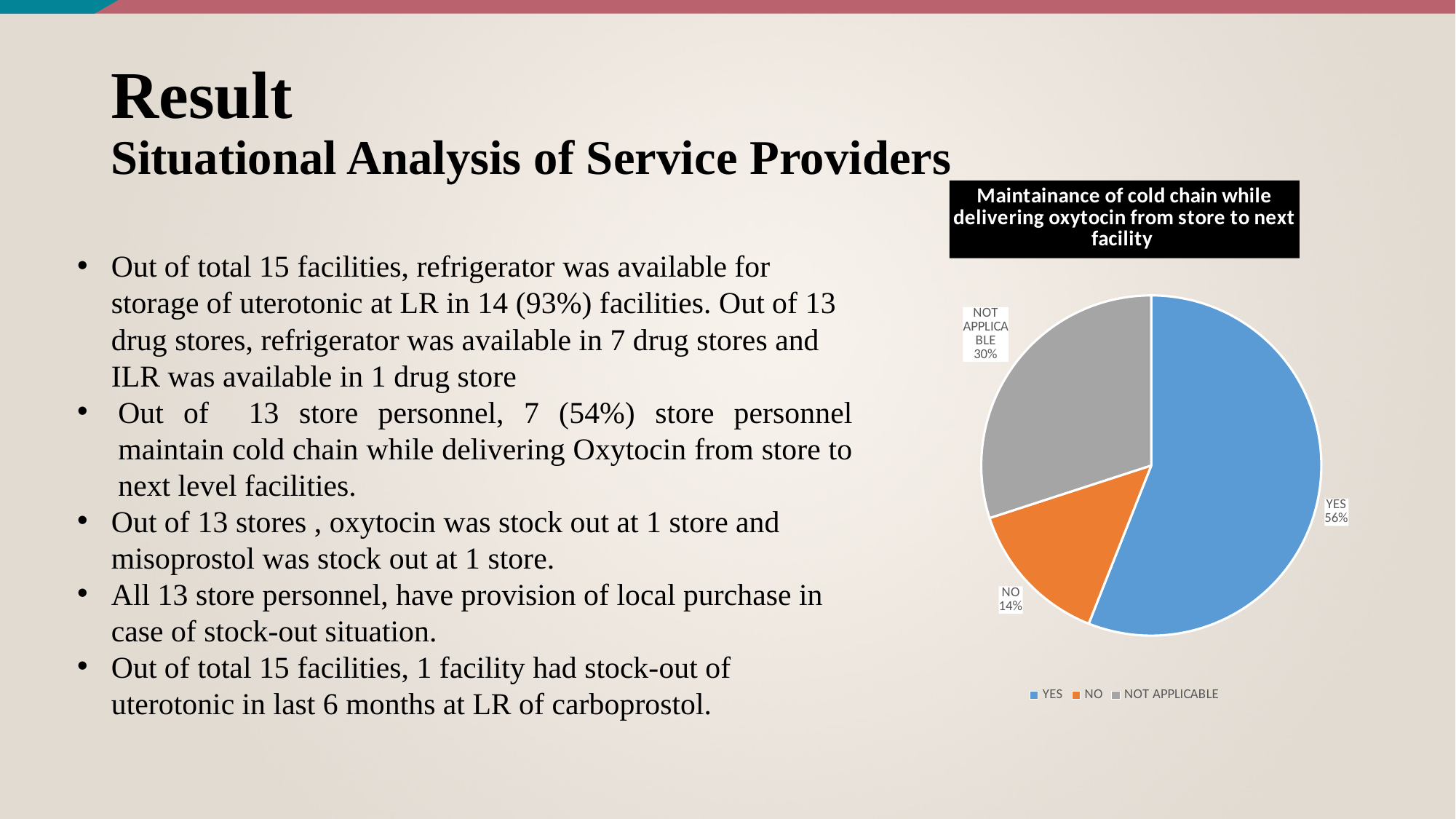
What share of the pie is labelled NO? 14% What share of the pie is labelled YES? 56% What is the difference in percentage points between the YES slice and the NOT APPLICABLE slice? 26 Which category has the smallest slice of the pie? NO What kind of chart is shown on the slide? pie chart What colour is the YES slice of the pie? blue Which category has the largest slice of the pie? YES Which slice is larger, NO or NOT APPLICABLE? NOT APPLICABLE What share of the pie is labelled NOT APPLICABLE? 30% How many slices does the pie chart have? 3 How many entries does the legend list? 3 What is the title of the chart? Maintainance of cold chain while delivering oxytocin from store to next facility